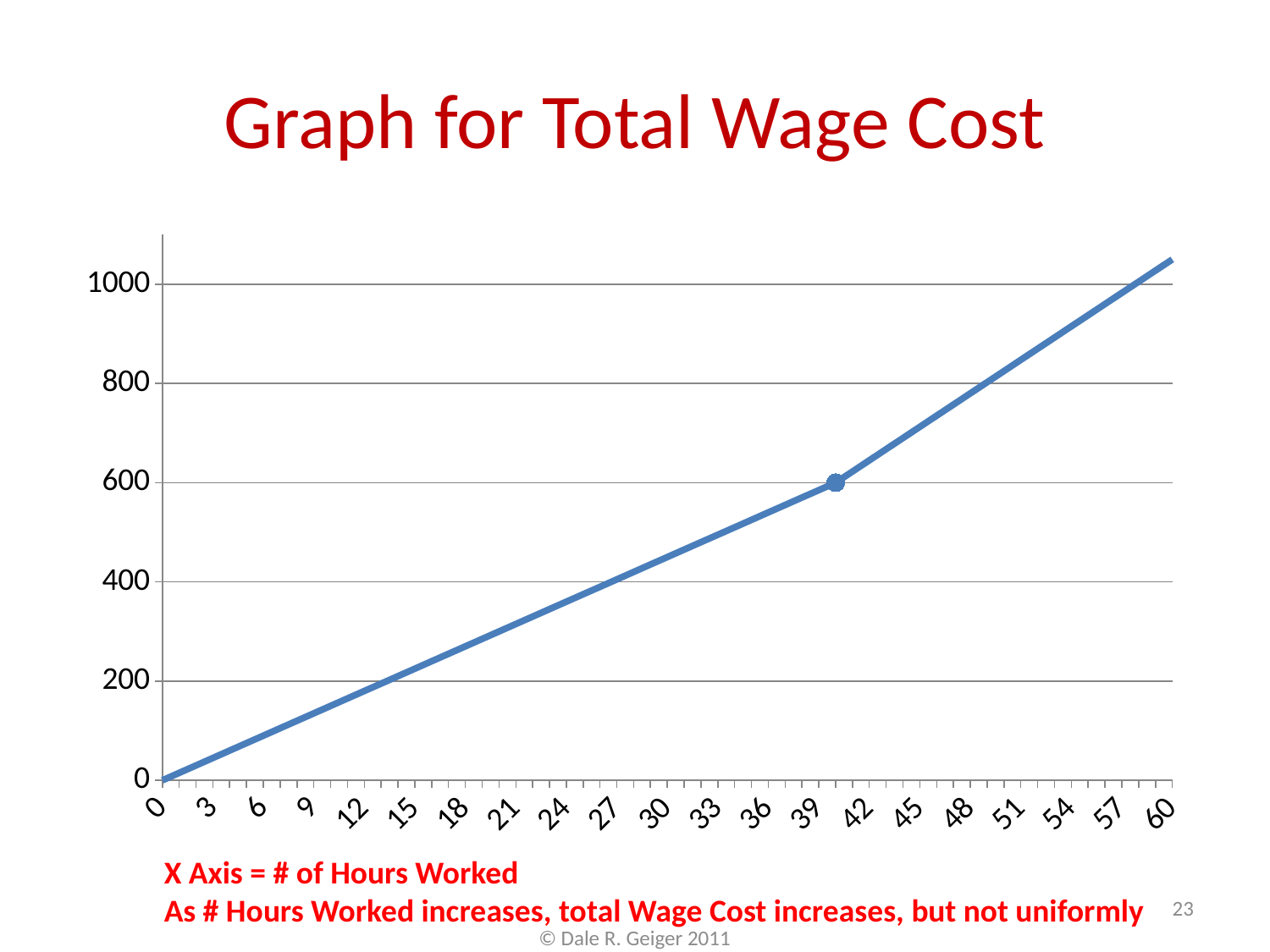
Is the value at 30 hours worked greater or less than 400? greater What is the total wage cost at 0 hours worked? 0 Does the total wage cost rise or fall as the number of hours worked increases? rise What is the total wage cost at 40 hours worked, where the marker is plotted? 600 According to the slide, what does the x axis represent? # of Hours Worked What kind of chart is shown on the slide? line chart How many tick labels are shown on the x axis? 21 Is the value at 9 hours worked greater or less than 200? less Is the value at 20 hours worked greater or less than 400? less What is the title of the chart? Graph for Total Wage Cost